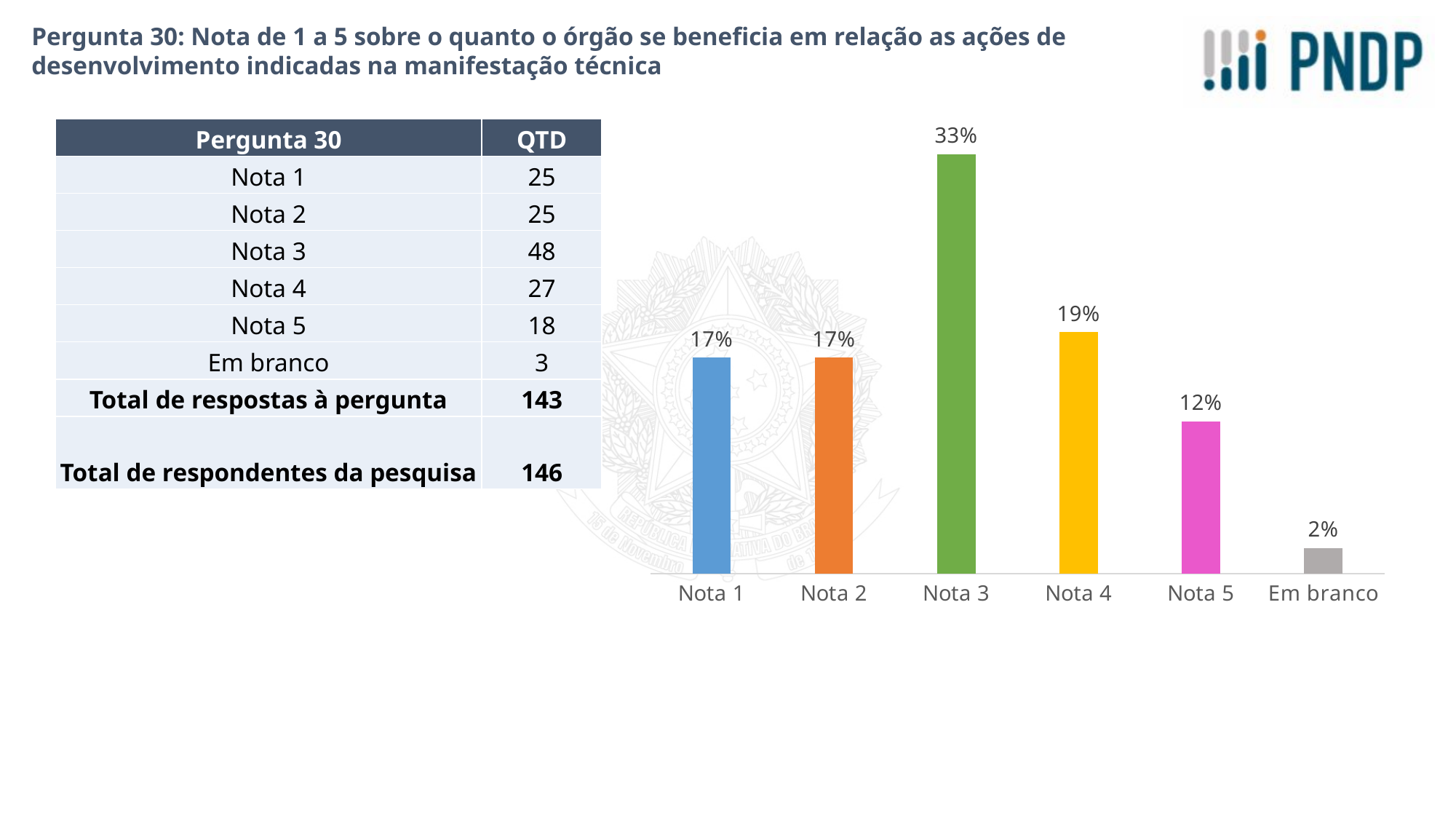
Do the percentages in the bar chart rise or fall from Nota 3 to Em branco? Fall What is the difference in percentage points between Nota 3 and Nota 4 in the bar chart? 14 What colour is the bar for Nota 3 in the bar chart? Green Which category has the lowest percentage in the bar chart? Em branco How many categories are shown on the x axis of the bar chart? 6 What percentage is shown for Em branco in the bar chart? 2% What percentage is shown for Nota 5 in the bar chart? 12% What percentage is shown for Nota 3 in the bar chart? 33% Which category has the highest percentage in the bar chart? Nota 3 What is the difference in percentage points between Nota 1 and Em branco in the bar chart? 15 Which has a larger percentage in the bar chart, Nota 4 or Nota 5? Nota 4 What kind of chart is shown on the slide? Bar chart